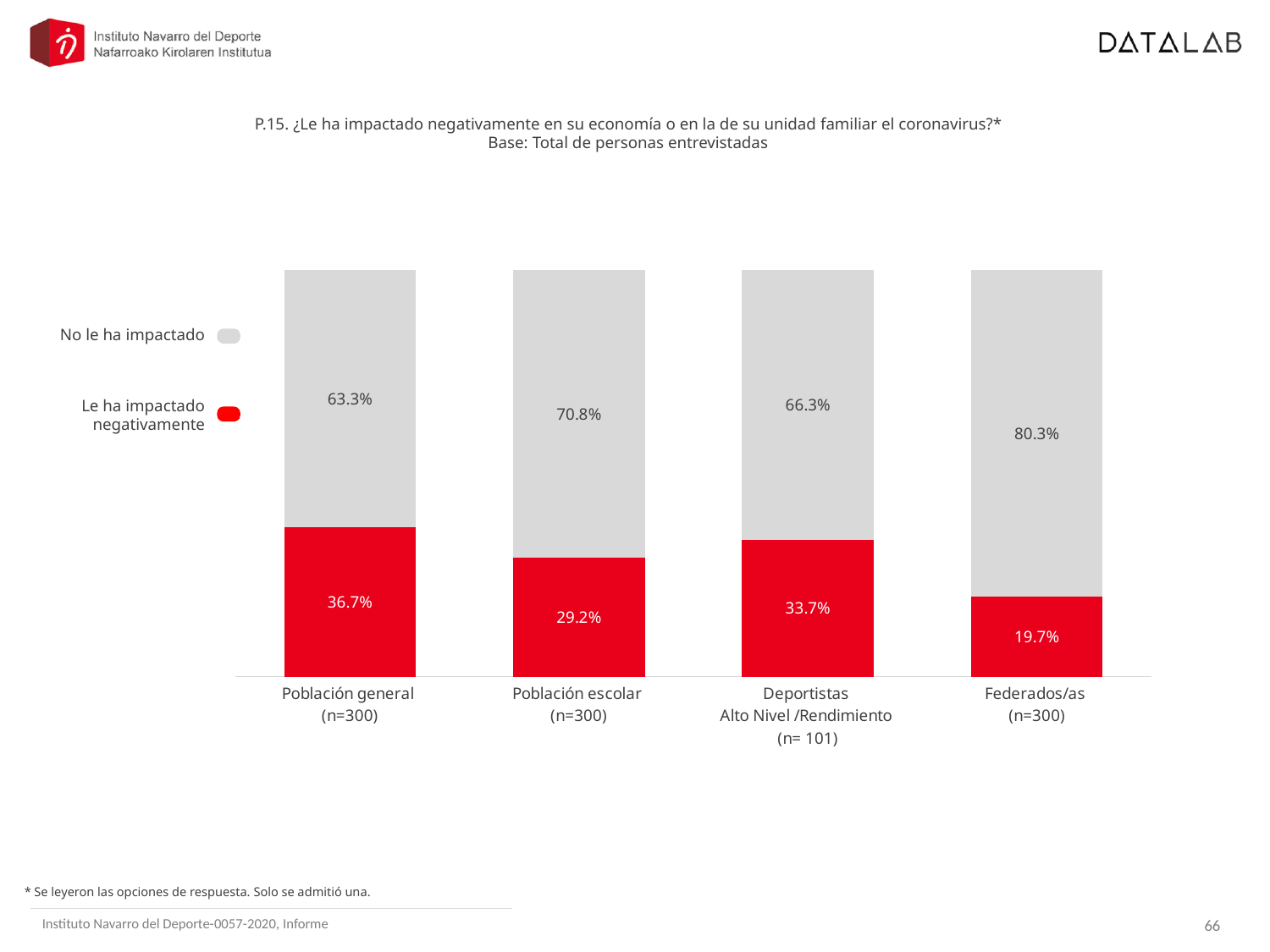
Which colour represents 'Le ha impactado negativamente' in the legend? Red What is the 'Le ha impactado negativamente' value for Deportistas Alto Nivel /Rendimiento? 33.7% What kind of chart is shown on the slide? Stacked bar chart What is the value of 'No le ha impactado' for Federados/as? 80.3% Which group has the highest 'Le ha impactado negativamente' percentage? Población general What percentage of Población general reported that the coronavirus impacted them negatively (Le ha impactado negativamente)? 36.7% Which group has the lowest 'Le ha impactado negativamente' percentage? Federados/as What is the total of the stacked bar for Población escolar? 100% Which is larger: the 'Le ha impactado negativamente' value for Población escolar or for Deportistas Alto Nivel /Rendimiento? Deportistas Alto Nivel /Rendimiento What is the difference between the 'No le ha impactado' values for Federados/as and Población general? 17.0 percentage points How many series does the legend list? 2 How many groups (categories) are shown on the x axis? 4